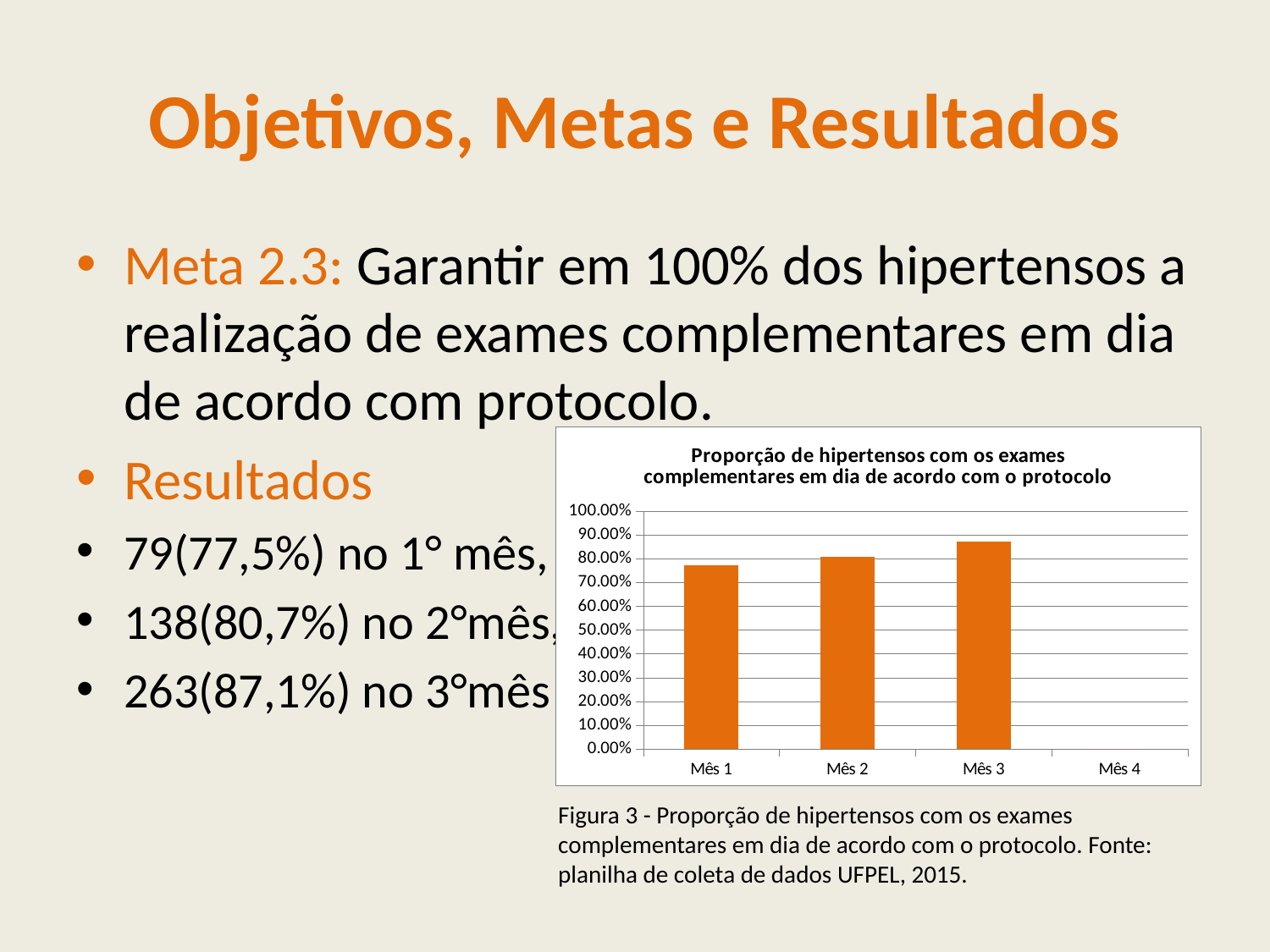
Do the bar values rise or fall from Mês 1 to Mês 3? rise Among the months with a plotted bar, which has the lowest value? Mês 1 How many bars are plotted in the chart? 3 What is the title of the chart? Proporção de hipertensos com os exames complementares em dia de acordo com o protocolo How many month categories are shown on the x axis of the chart? 4 Is the value for Mês 1 greater or less than 70.00%? greater Is the value for Mês 2 greater or less than 100.00%? less Which is larger, the value for Mês 1 or the value for Mês 3? Mês 3 Which month has the highest bar in the chart? Mês 3 According to the slide, what proportion of hypertensive patients had their complementary exams up to date in the 1st month? 77,5% Is the value for Mês 3 greater or less than 80.00%? greater What kind of chart is shown on the slide? bar chart